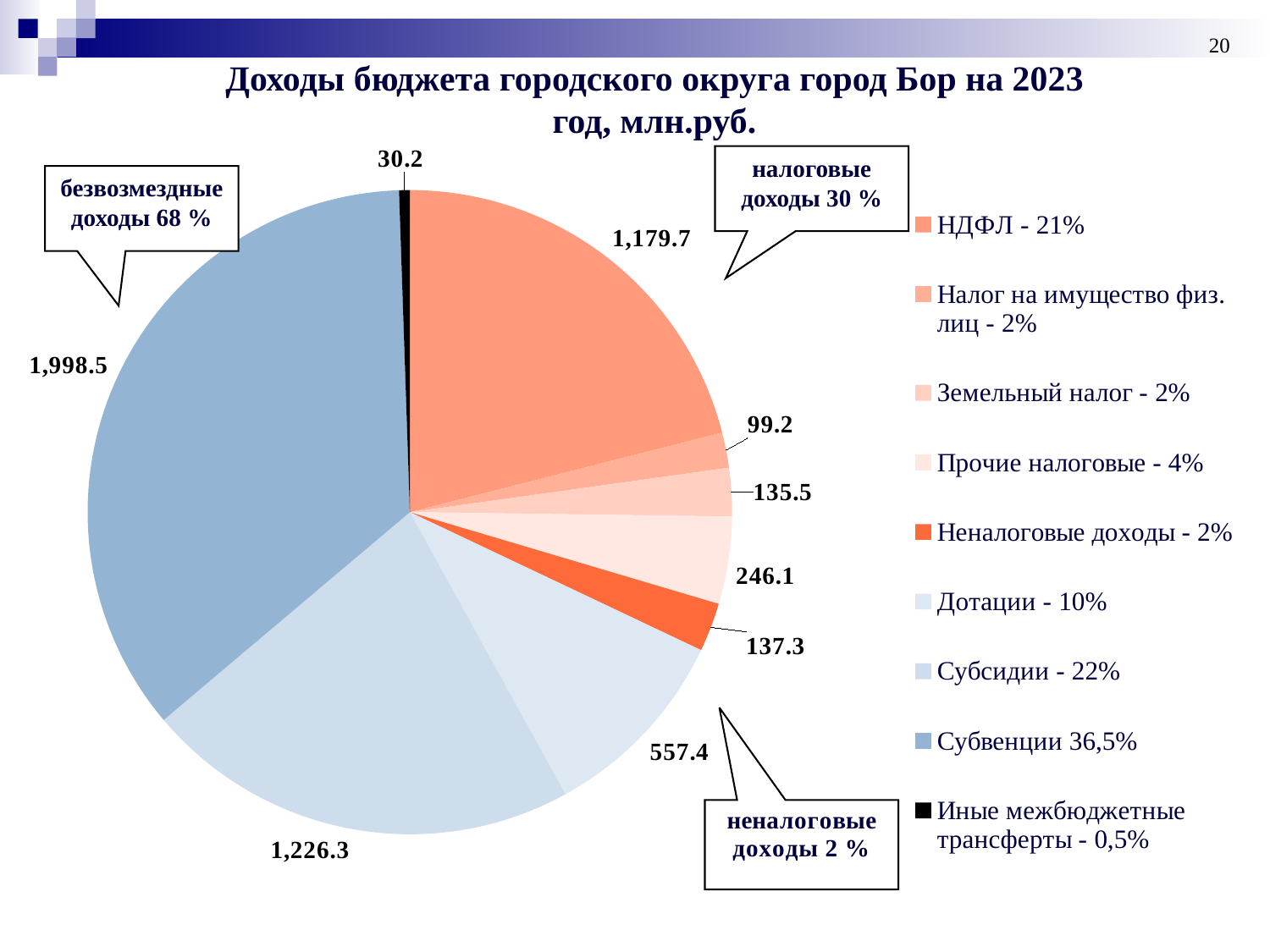
How many slices does the pie chart have? 9 What share of the pie does Субсидии represent according to the legend? 22% What is the value of the Иные межбюджетные трансферты slice? 30.2 What is the difference between the Субвенции value and the Субсидии value? 772.2 Which category has the smallest slice of the pie? Иные межбюджетные трансферты What is the value of the Дотации slice? 557.4 Which category has the largest slice of the pie? Субвенции What is the value of the Субвенции slice? 1,998.5 What is the title of the chart? Доходы бюджета городского округа город Бор на 2023 год, млн.руб. What kind of chart is shown on the slide? pie chart What is the value of the НДФЛ slice? 1,179.7 Which is larger, Прочие налоговые or Неналоговые доходы? Прочие налоговые